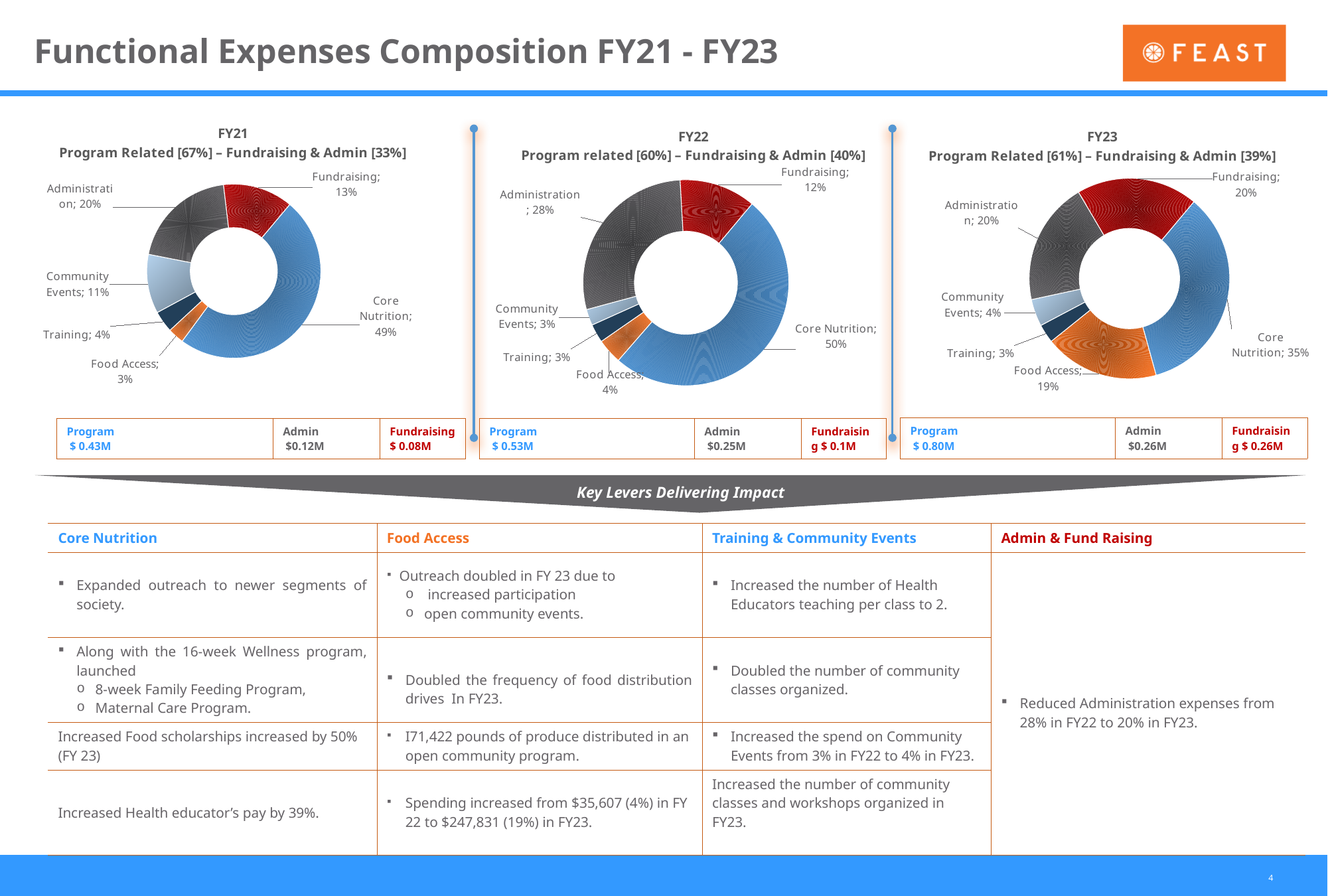
In the FY21 chart, which category has the smallest share? Food Access In the FY21 chart, which is larger: Administration or Fundraising? Administration In the FY22 chart, which category has the largest share? Core Nutrition In the FY23 chart, which category has the largest share? Core Nutrition In the FY23 chart, what is the difference between the Core Nutrition share and the Food Access share? 16% In the FY23 chart, which category has the smallest share? Training In the FY22 chart, what share of expenses is Administration? 28% In the FY23 chart, what share of expenses is Food Access? 19% What is the title of the chart on the right of the slide? FY23 Program Related [61%] – Fundraising & Admin [39%] What kind of chart is used for FY21? Donut chart In the FY21 chart, what share of expenses is Core Nutrition? 49% How many categories does the FY22 chart show? 6